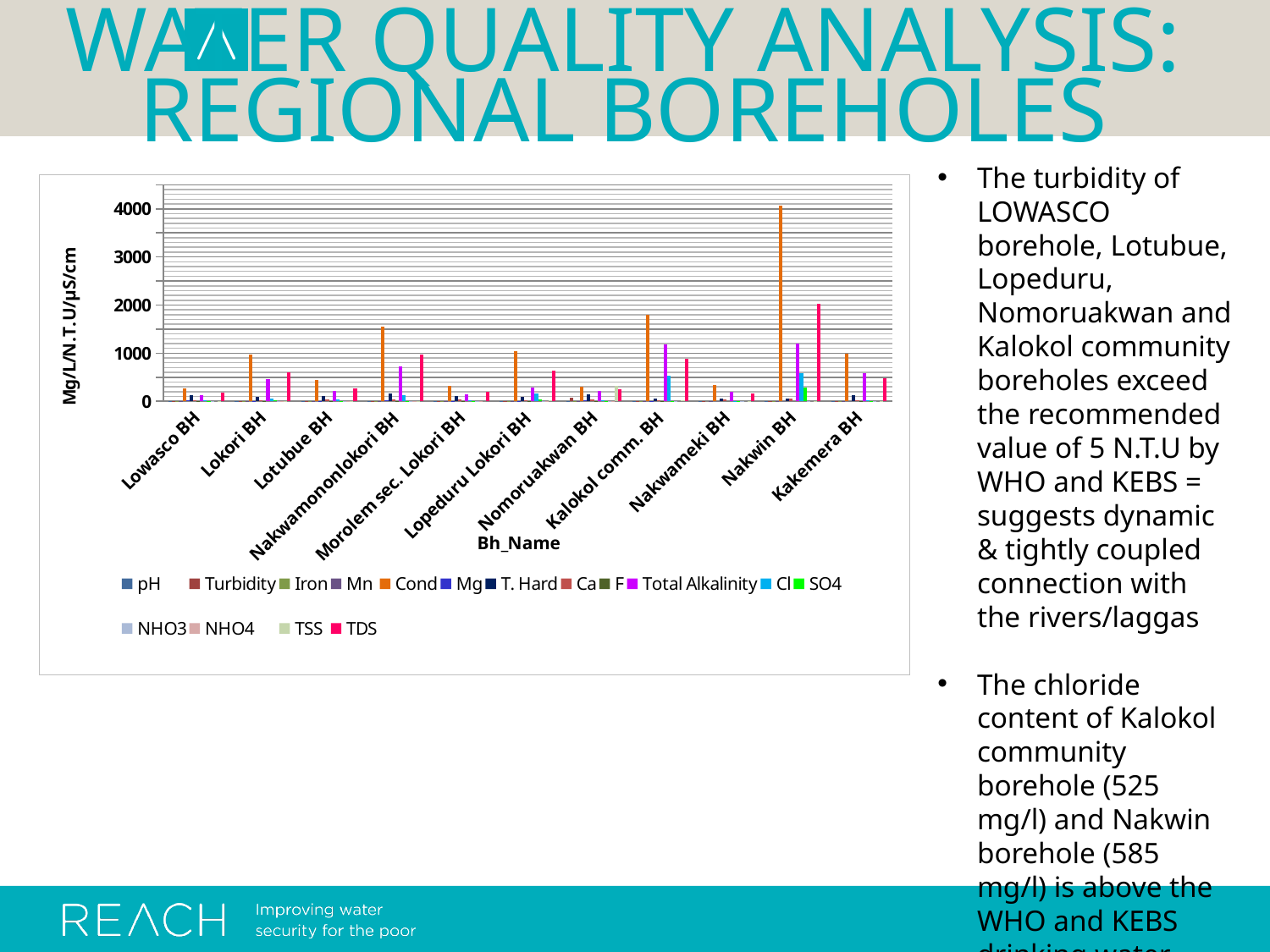
Is the TDS value for Nakwin BH greater or less than 1000? greater What is the title of the x axis of the chart? Bh_Name Is the Cond value for Nakwin BH greater or less than 3000? greater Is the Cond value for Kalokol comm. BH greater or less than 1000? greater Which borehole has the highest Cond value in the chart? Nakwin BH Which has the larger Cond value, Nakwin BH or Kalokol comm. BH? Nakwin BH How many series does the chart's legend list? 16 Which has the larger Cond value, Nakwamononlokori BH or Lotubue BH? Nakwamononlokori BH What is the label on the vertical axis of the chart? Mg/L/N.T.U/µS/cm What kind of chart is shown on the slide? bar chart How many boreholes (categories) are shown on the x axis of the chart? 11